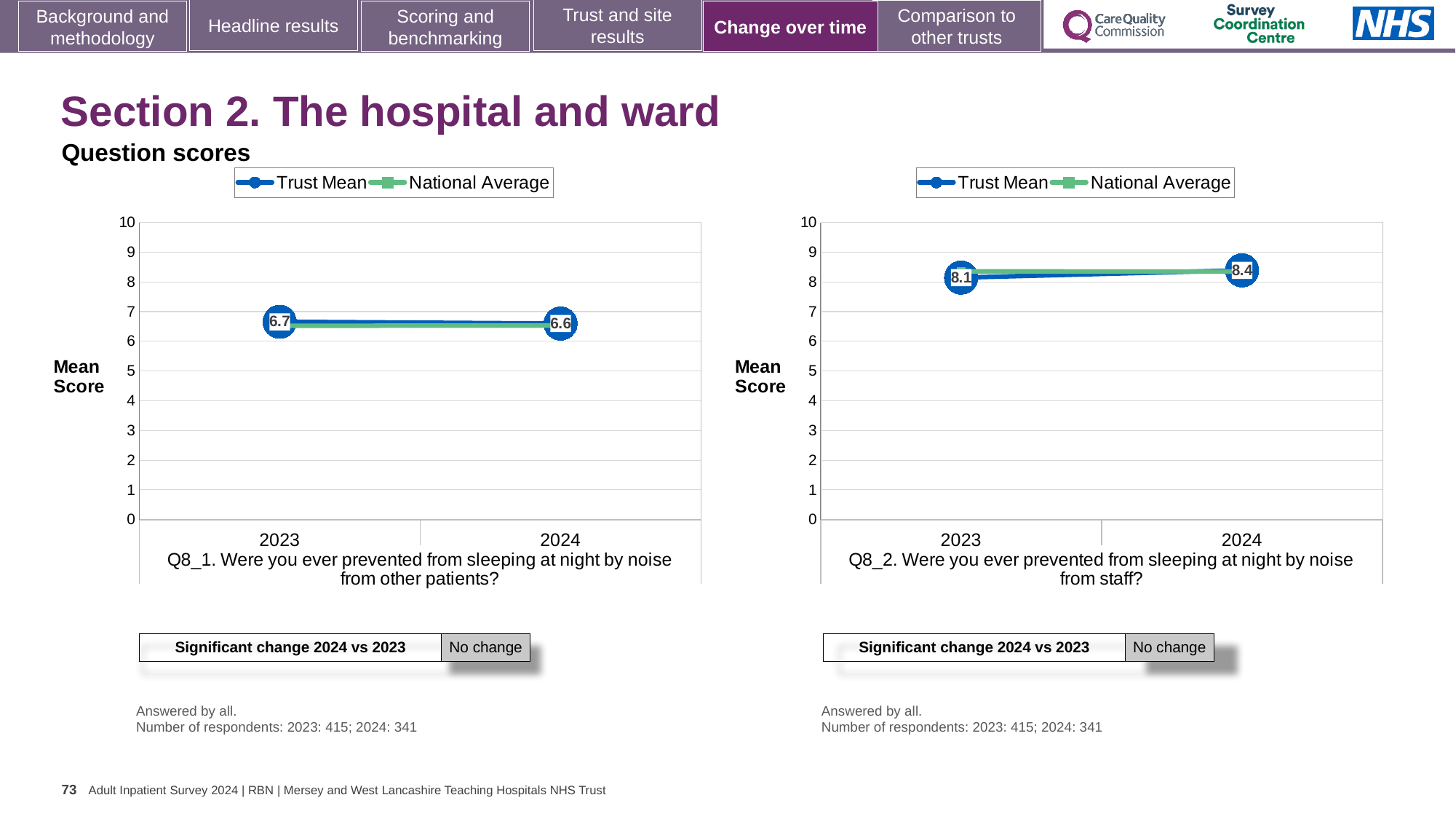
In the Q8_2 chart (right), by how much did the Trust Mean change from 2023 to 2024? 0.3 In the Q8_2 chart (right), does the Trust Mean rise or fall from 2023 to 2024? rise In the Q8_2 chart (right), what is the Trust Mean score for 2023? 8.1 In the Q8_1 chart (left), what is the Trust Mean score for 2024? 6.6 In the Q8_1 chart (left), is the Trust Mean for 2024 greater or less than 7? less How many series does the legend of the Q8_2 chart (right) list? 2 How many years are shown on the x axis of the Q8_1 chart (left)? 2 What kind of chart is the Q8_1 chart (left)? line chart In the Q8_2 chart (right), what is the Trust Mean score for 2024? 8.4 In the Q8_1 chart (left), what is the Trust Mean score for 2023? 6.7 In the Q8_2 chart (right), is the Trust Mean for 2023 greater or less than 8? greater In the Q8_1 chart (left), what is the difference between the Trust Mean for 2023 and 2024? 0.1